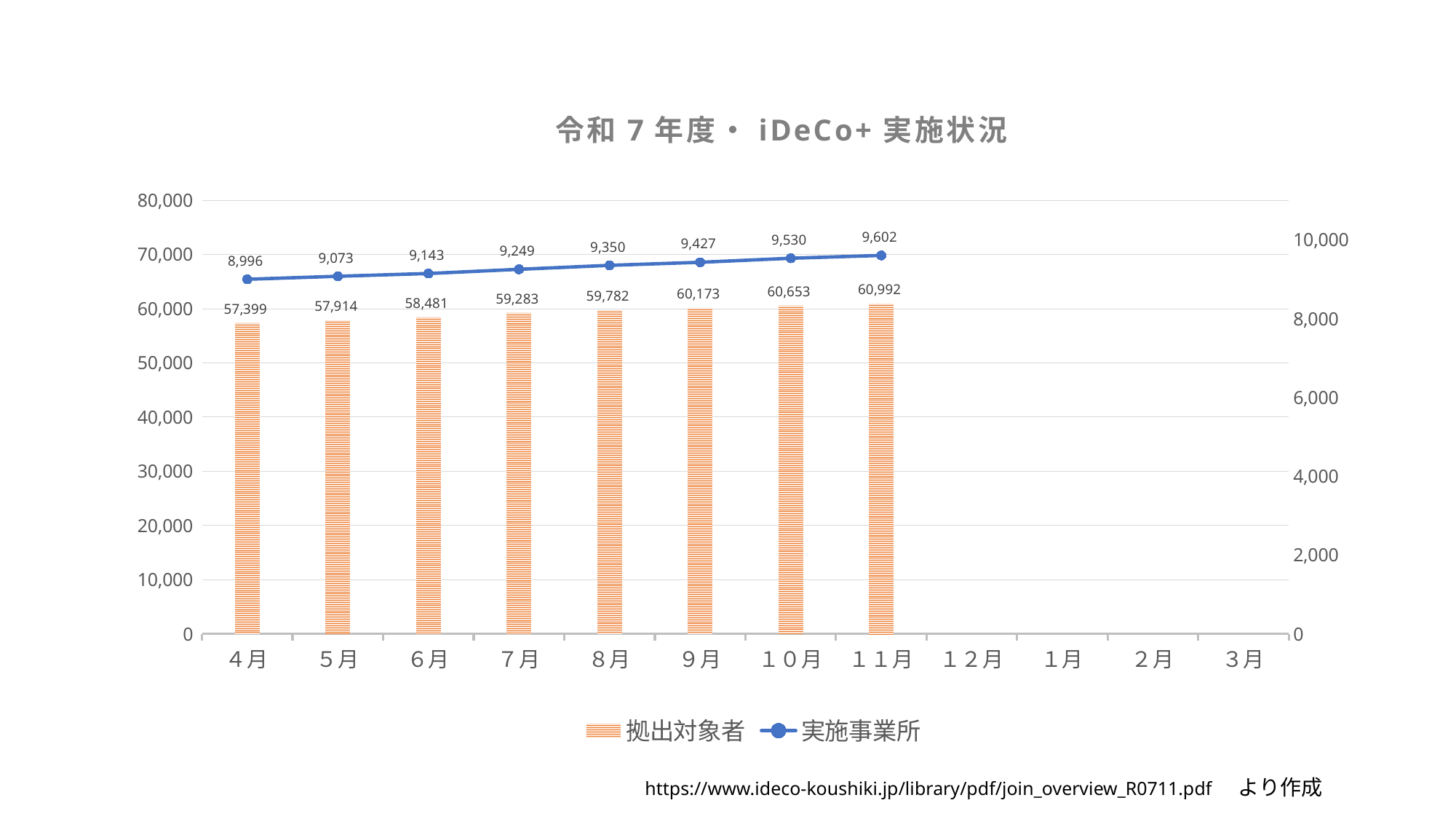
Do the 実施事業所 values rise or fall from 4月 to 11月? rise What is the value of 実施事業所 for 11月? 9,602 Which month has the lowest value for 実施事業所? 4月 What is the difference between the 実施事業所 values for 10月 and 9月? 103 How many months have data plotted for 拠出対象者? 8 How many series does the legend list? 2 What is the difference between the 拠出対象者 values for 11月 and 4月? 3,593 What is the value of 拠出対象者 for 4月? 57,399 Which month has the highest value for 拠出対象者? 11月 What is the value of 実施事業所 for 8月? 9,350 Which is larger, the 拠出対象者 value for 7月 or for 6月? 7月 What is the title of the chart? 令和7年度・iDeCo+実施状況